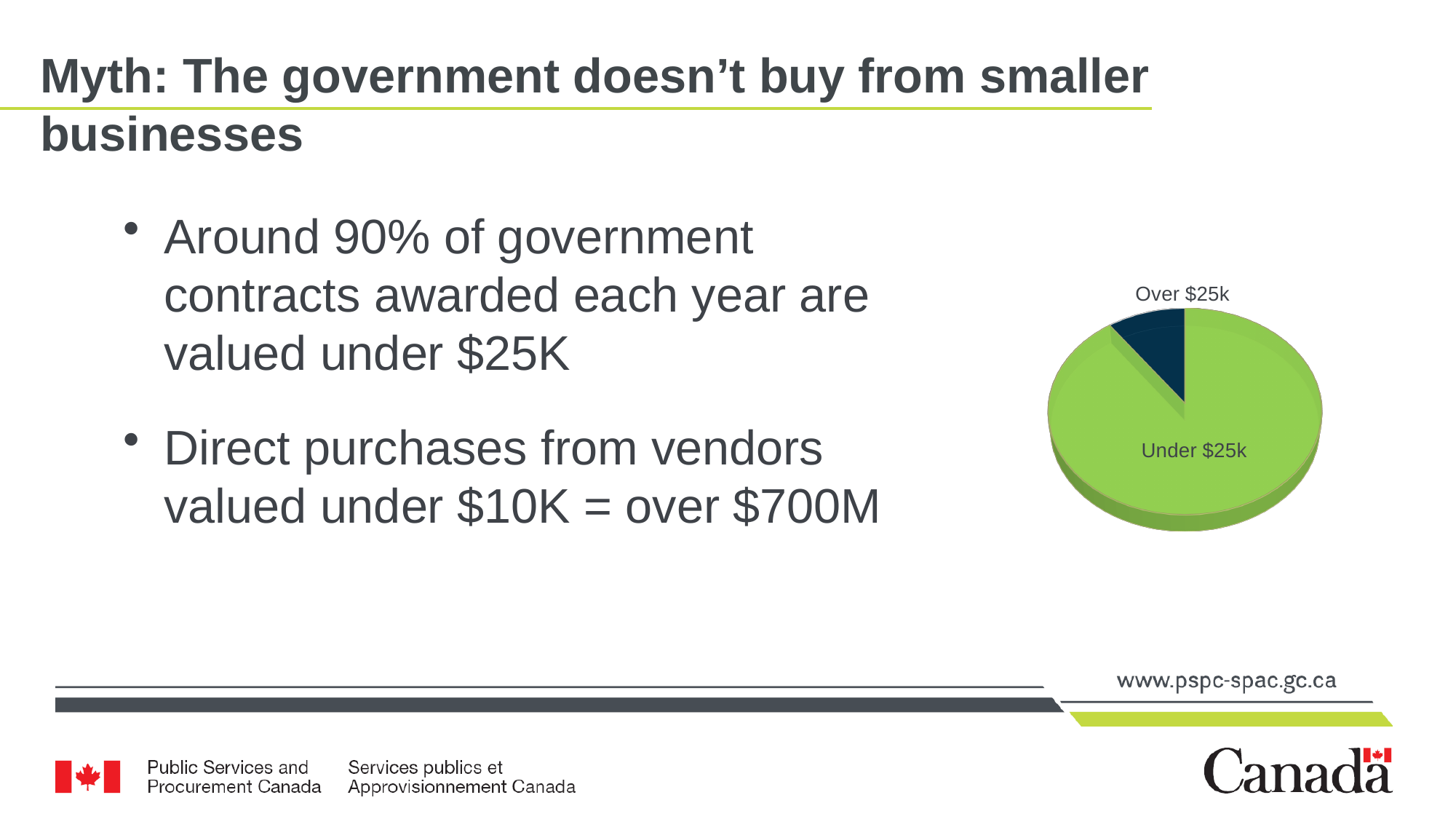
Which slice of the pie chart is the largest? Under $25k What kind of chart is shown on the slide? Pie chart Which slice of the pie chart is the smallest? Over $25k What colour is the Under $25k slice in the pie chart? Green How many slices does the pie chart have? 2 What are the labels of the two slices in the pie chart? Over $25k and Under $25k Which slice is larger in the pie chart, Under $25k or Over $25k? Under $25k